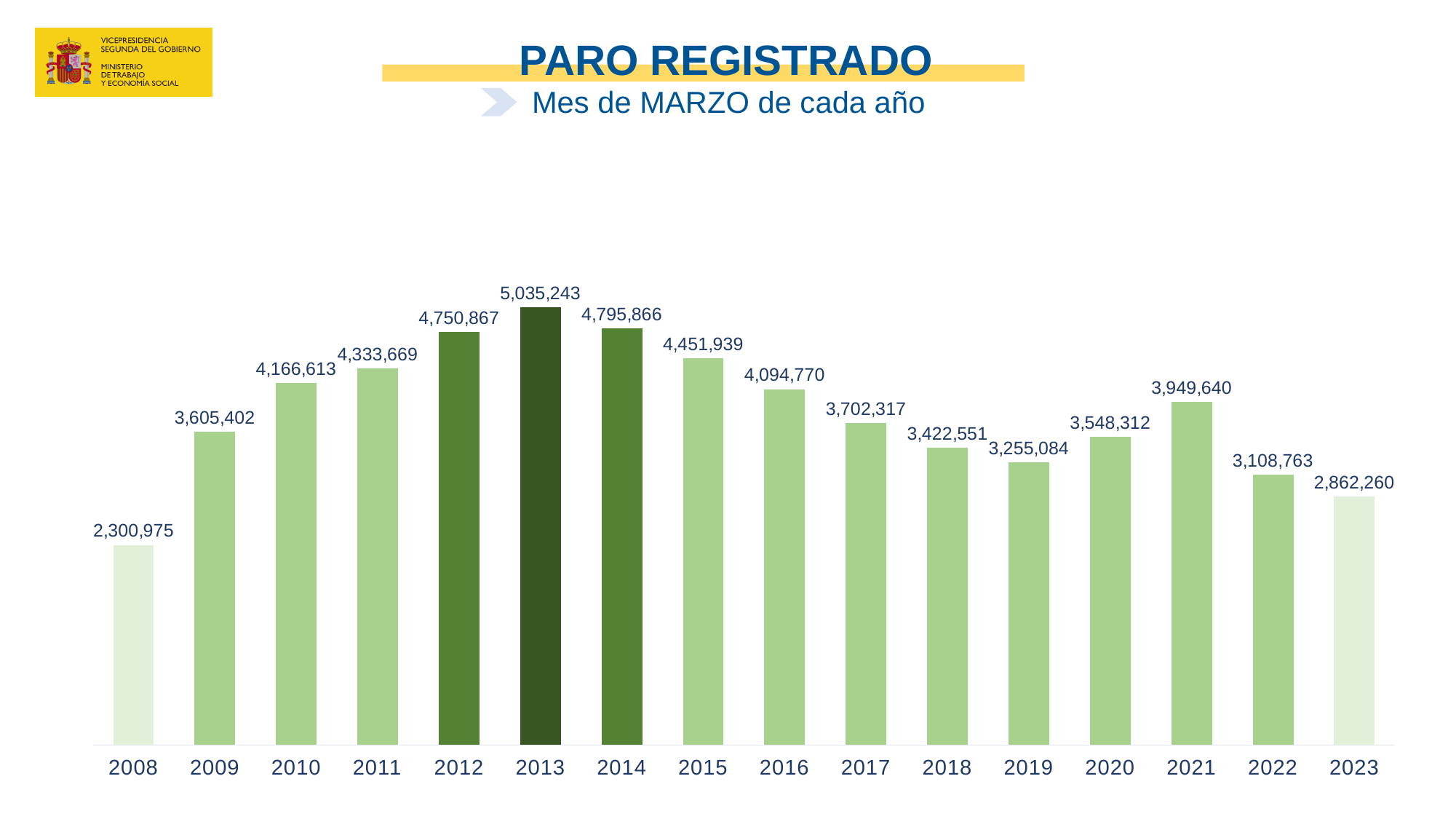
Do the values rise or fall from 2013 to 2019? Fall How many years are shown on the x axis? 16 Which year has the lowest value in the chart? 2008 What is the difference between the values for 2022 and 2023? 246,503 What is the registered unemployment value for March 2013? 5,035,243 Which is larger, the value for 2012 or the value for 2014? 2014 Which year has the highest value in the chart? 2013 What is the value shown for 2008? 2,300,975 What is the subtitle below the chart title 'PARO REGISTRADO'? Mes de MARZO de cada año What kind of chart is shown on the slide? Bar chart What is the difference between the values for 2021 and 2020? 401,328 What is the value shown for 2023? 2,862,260